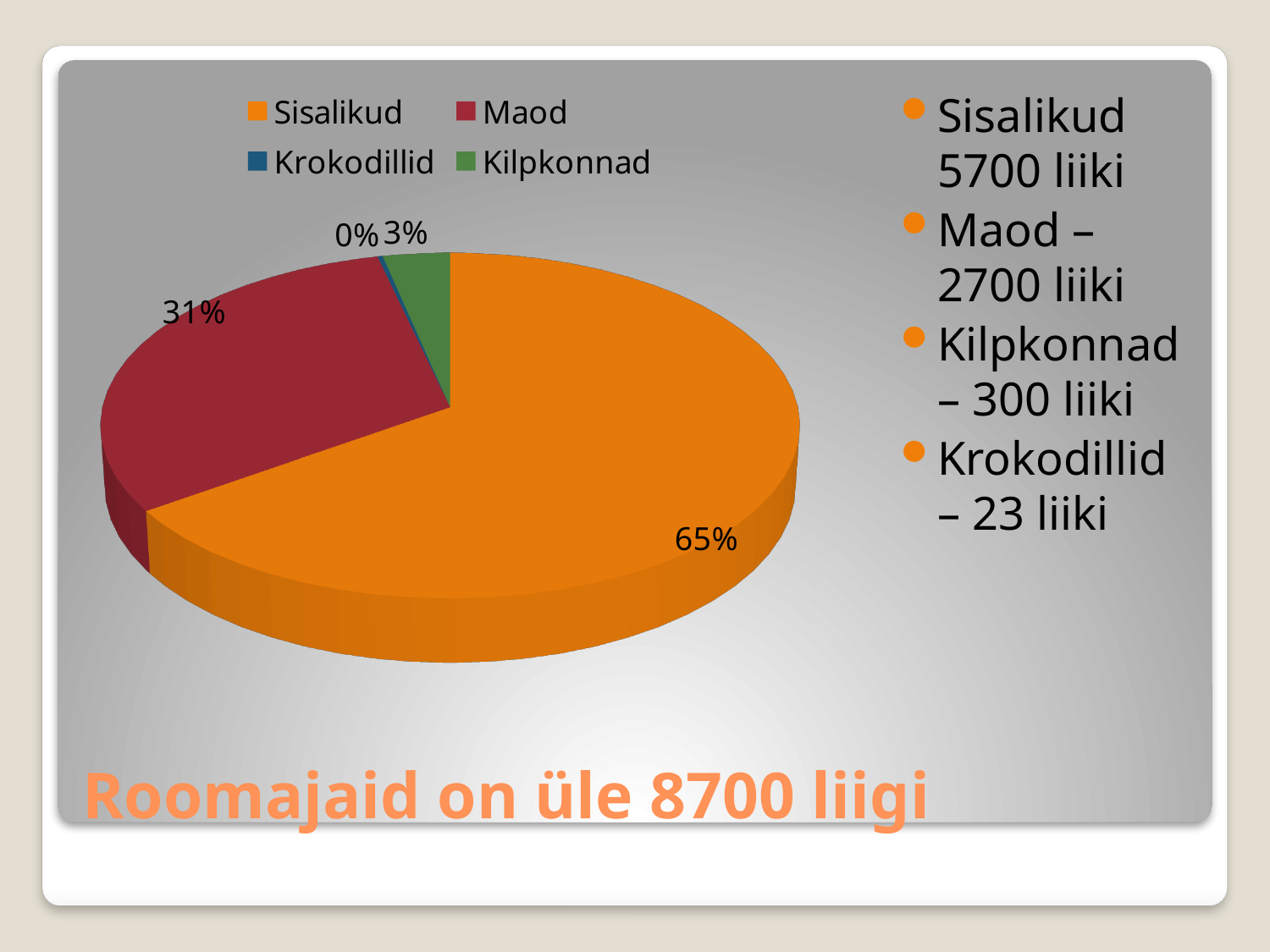
What kind of chart is shown on the slide? pie chart What percentage of the pie does Sisalikud account for? 65% What percentage of the pie does Kilpkonnad account for? 3% What is the difference in percentage points between the Sisalikud and Maod slices? 34 Which slice is larger, Maod or Kilpkonnad? Maod Which legend entry is shown in green? Kilpkonnad Which category has the smallest slice of the pie? Krokodillid Which category has the largest slice of the pie? Sisalikud What percentage label is shown for Krokodillid? 0% What colour is the Sisalikud slice in the pie chart? orange How many categories does the pie chart show? 4 What percentage of the pie does Maod account for? 31%